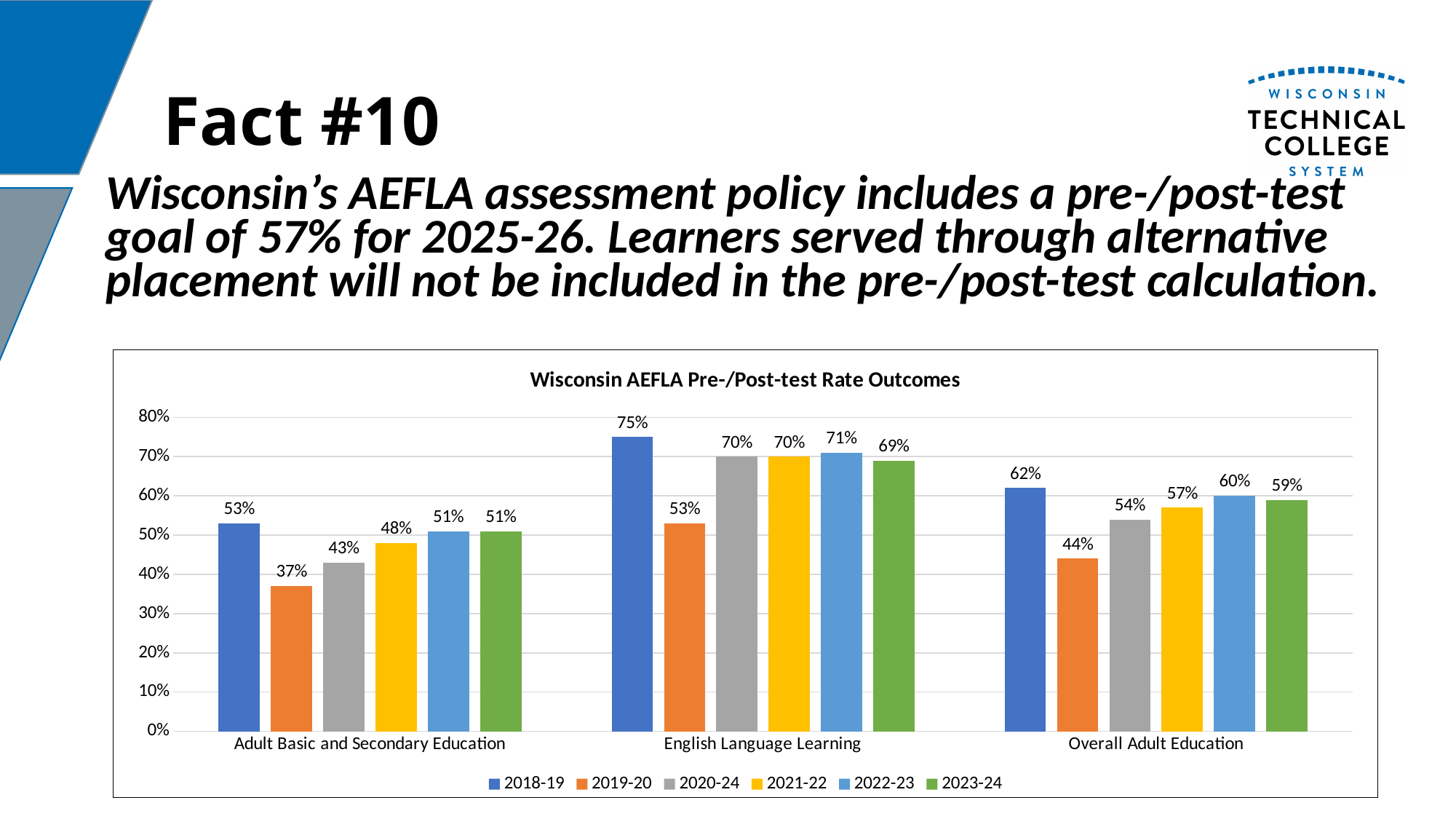
Which is larger for 2023-24: the rate for English Language Learning or the rate for Overall Adult Education? English Language Learning What is the pre-/post-test rate for English Language Learning in 2018-19? 75% What is the pre-/post-test rate for Overall Adult Education in 2021-22? 57% What kind of chart is shown on the slide? Bar chart How many series does the legend list? 6 Which year has the highest pre-/post-test rate for Overall Adult Education? 2018-19 What is the difference between the 2018-19 and 2019-20 rates for English Language Learning? 22% Which year has the lowest pre-/post-test rate for Adult Basic and Secondary Education? 2019-20 What is the title of the chart? Wisconsin AEFLA Pre-/Post-test Rate Outcomes What is the difference between the 2022-23 and 2020-24 rates for Overall Adult Education? 6% What is the pre-/post-test rate for Adult Basic and Secondary Education in 2019-20? 37% How many categories are shown on the x axis? 3